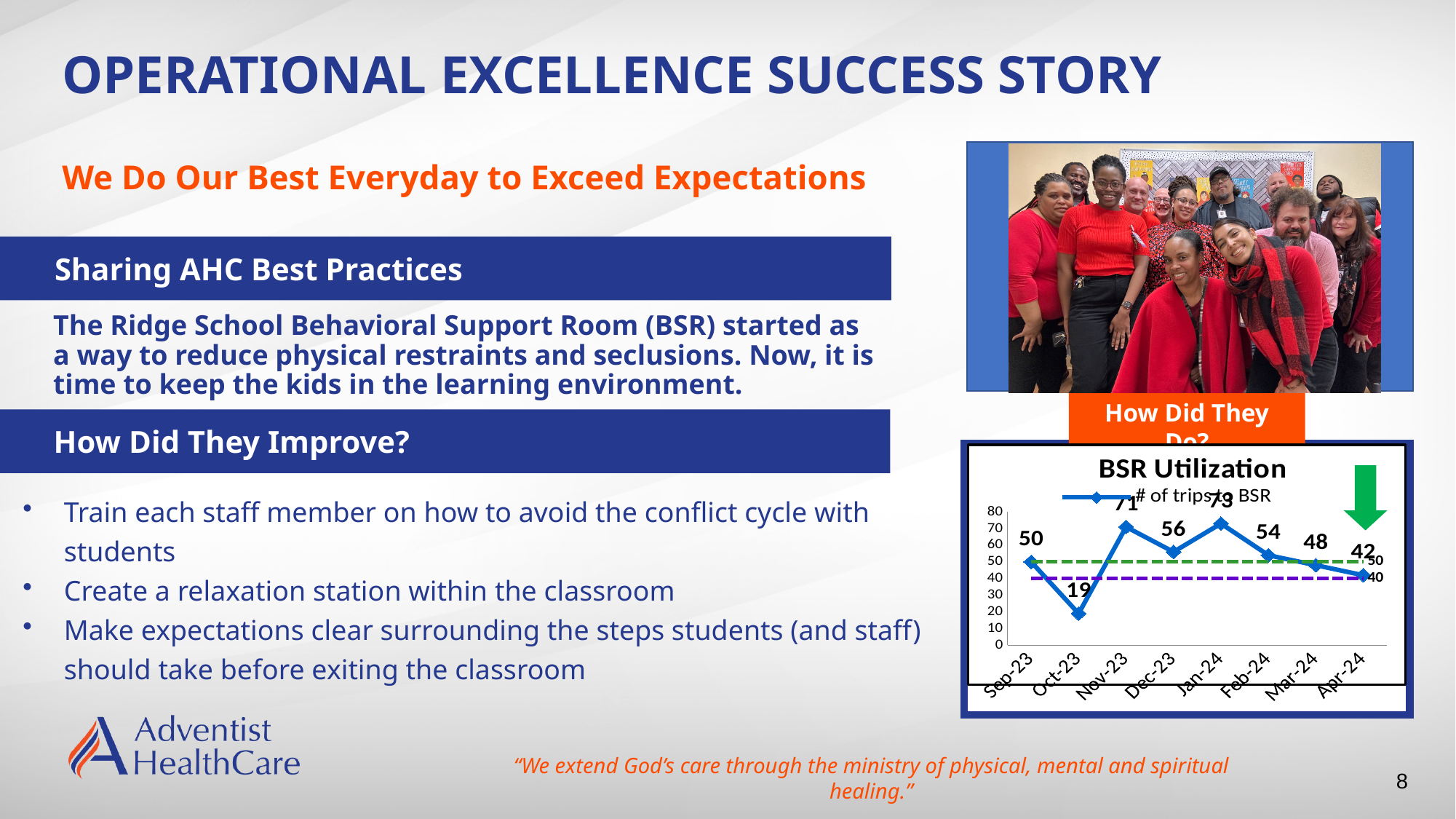
In the BSR Utilization chart, which month has the lowest number of trips to BSR? Oct-23 What kind of chart is the BSR Utilization chart? line chart In the BSR Utilization chart, what is the difference between the number of trips in Nov-23 and Dec-23? 15 What is the title of the chart on the slide? BSR Utilization In the BSR Utilization chart, what is the number of trips to BSR in Jan-24? 73 In the BSR Utilization chart, what is the number of trips to BSR in Oct-23? 19 How many series does the legend of the BSR Utilization chart list? 1 In the BSR Utilization chart, which month has the highest number of trips to BSR? Jan-24 In the BSR Utilization chart, which month has more trips to BSR, Sep-23 or Mar-24? Sep-23 In the BSR Utilization chart, do the values rise or fall from Jan-24 to Apr-24? fall How many months are plotted in the BSR Utilization chart? 8 In the BSR Utilization chart, what is the number of trips to BSR in Apr-24? 42